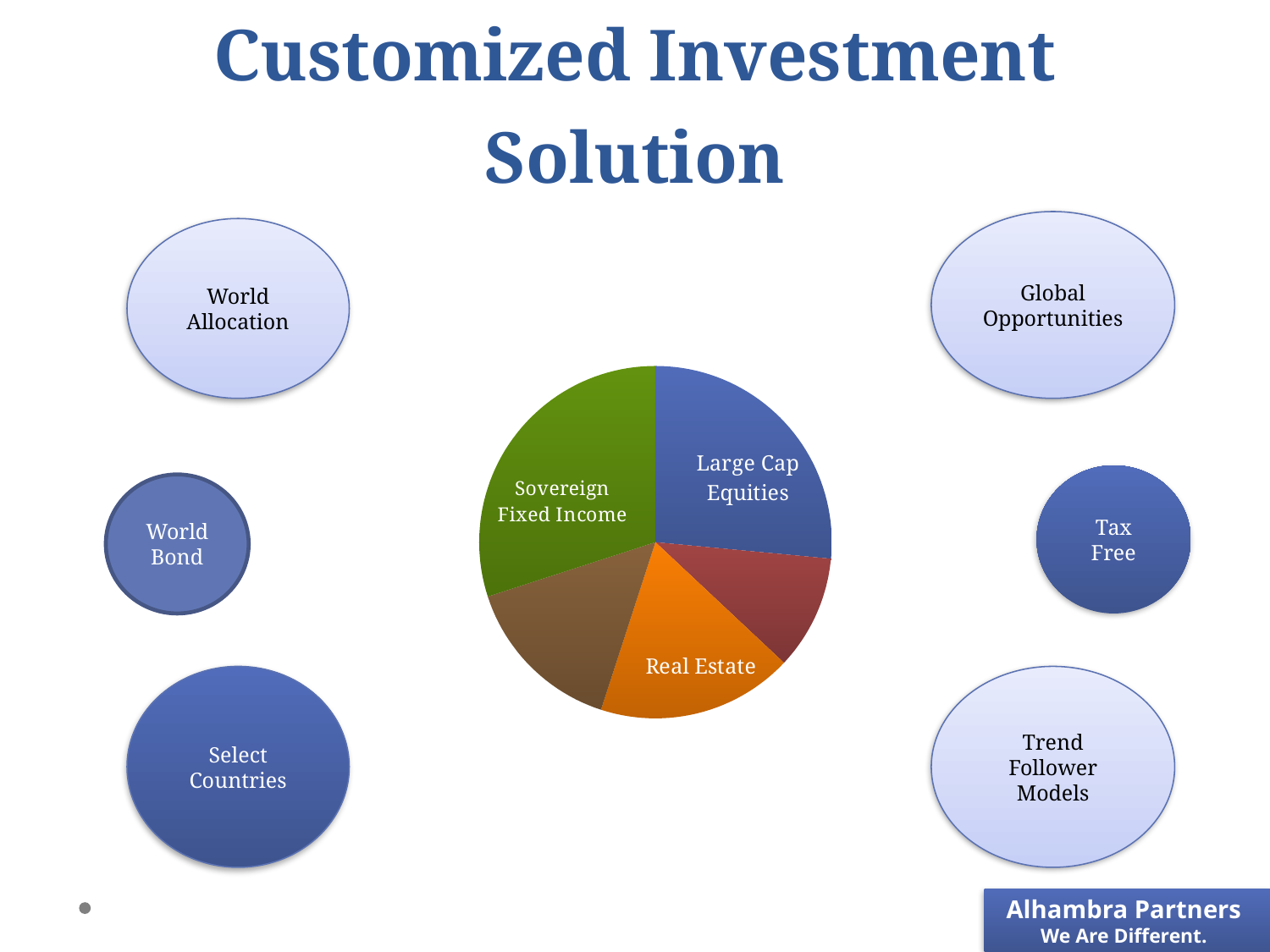
Which labelled slice of the pie chart is the largest? Sovereign Fixed Income Which labelled slice of the pie chart is the smallest? Real Estate How many slices does the pie chart have? 5 Which is larger in the pie chart, Sovereign Fixed Income or Real Estate? Sovereign Fixed Income What colour is the Sovereign Fixed Income slice of the pie chart? green Which slice of the pie chart is coloured blue? Large Cap Equities How many slices of the pie chart have a text label? 3 What colour is the Real Estate slice of the pie chart? orange Which is larger in the pie chart, Large Cap Equities or Real Estate? Large Cap Equities What kind of chart is shown in the centre of the slide? pie chart